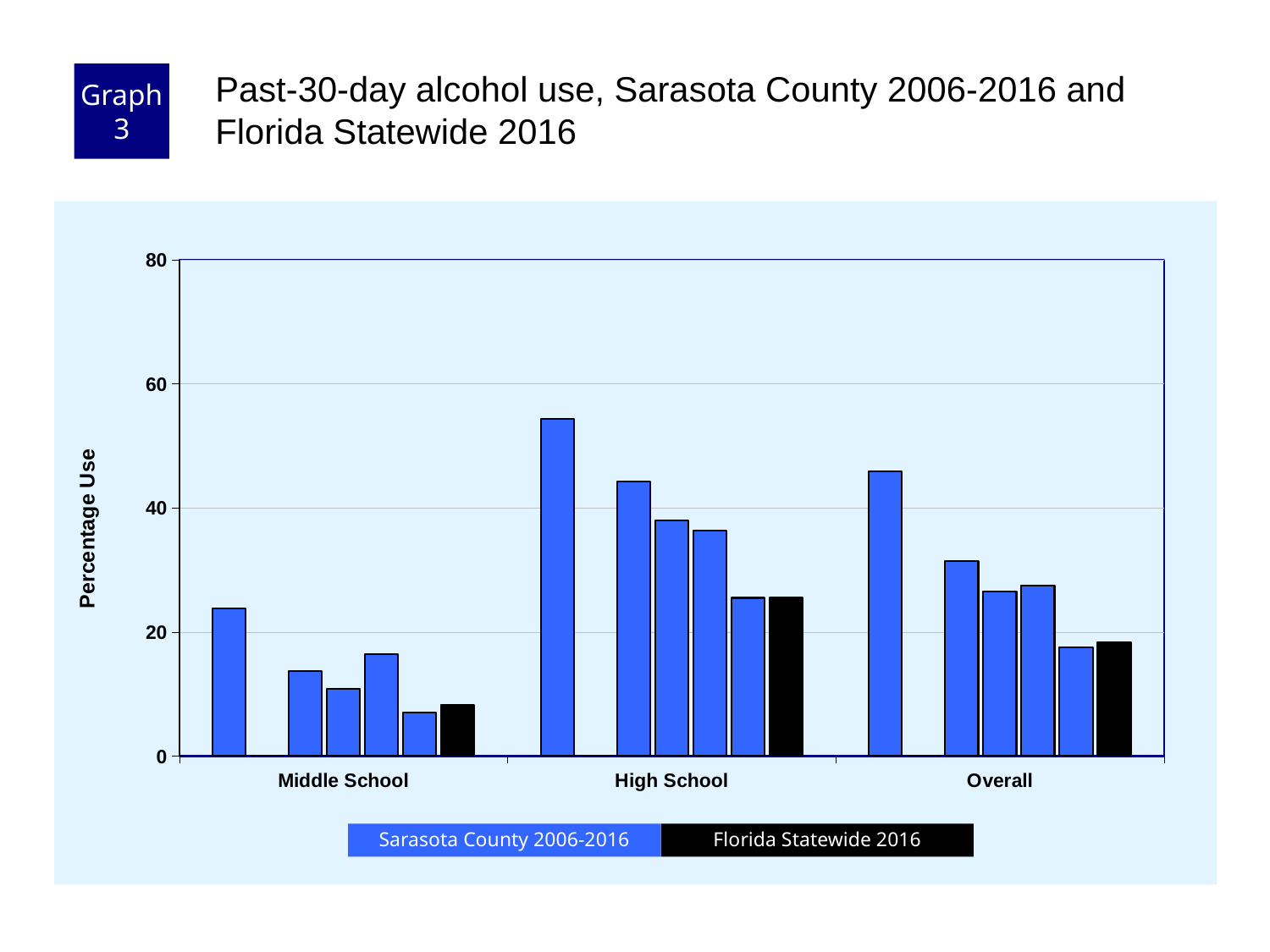
What is the label on the y axis? Percentage Use Which category has the highest Florida Statewide 2016 value? High School How many series does the legend list? 2 Is the Florida Statewide 2016 value for Middle School greater or less than 20? less What is the title of the chart? Past-30-day alcohol use, Sarasota County 2006-2016 and Florida Statewide 2016 Which is larger, the Florida Statewide 2016 value for High School or for Middle School? High School What kind of chart is shown on the slide? bar chart Is the Florida Statewide 2016 value for High School greater or less than 20? greater Is the Florida Statewide 2016 value for Overall greater or less than 40? less Which category has the lowest Florida Statewide 2016 value? Middle School How many categories are shown on the x axis? 3